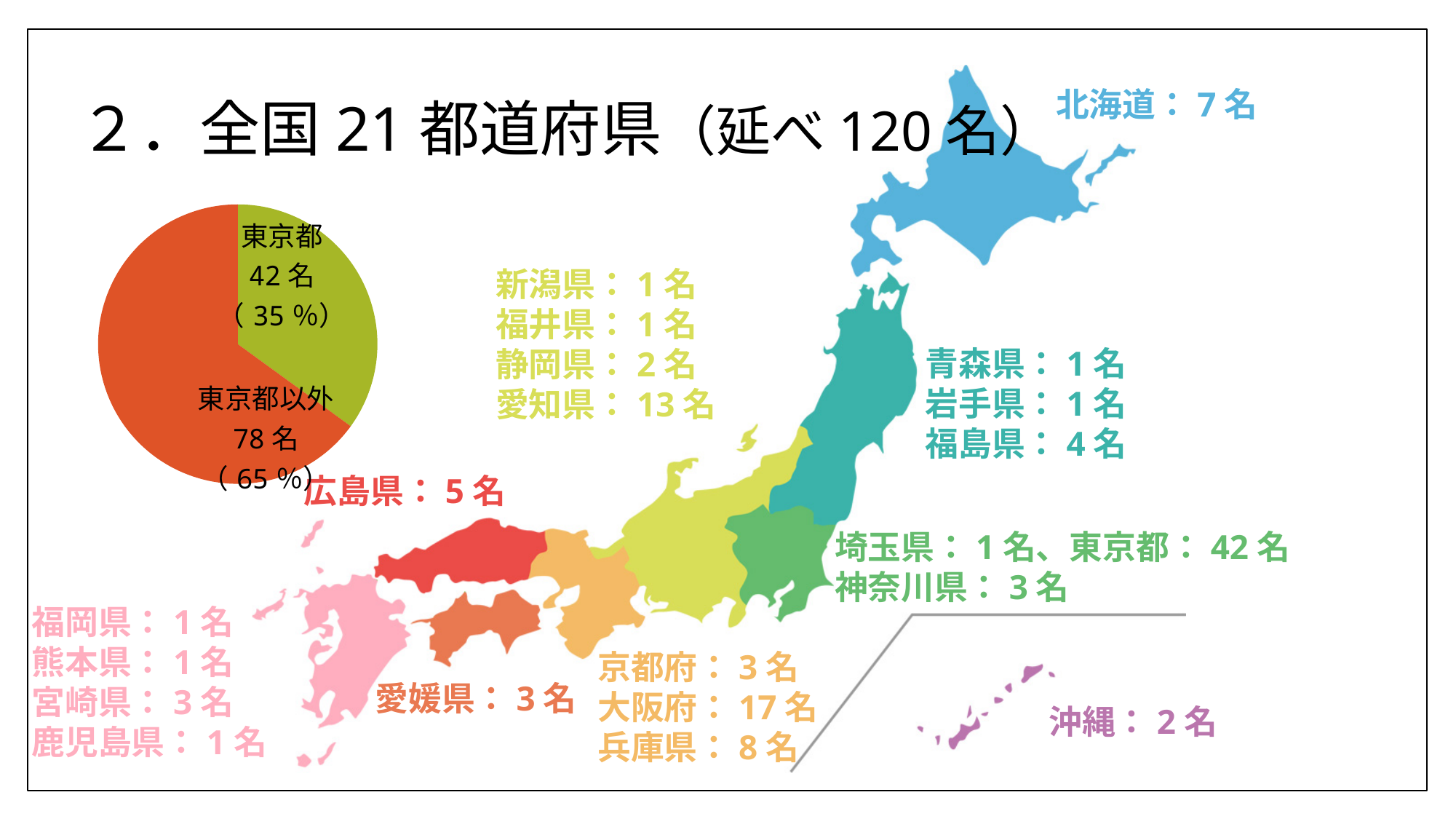
What colour is the 東京都 slice in the pie chart? yellow-green How many slices does the pie chart have? 2 In the pie chart, how many people are in the 東京都以外 slice? 78 名 In the pie chart, what share does the 東京都 slice represent? 35 % What kind of chart is shown on the left of the slide? pie chart Which slice of the pie chart is larger, 東京都 or 東京都以外? 東京都以外 What colour is the 東京都以外 slice in the pie chart? orange-red Which slice of the pie chart is the smallest? 東京都 In the pie chart, how many people are in the 東京都 slice? 42 名 What is the total number of people across both slices of the pie chart? 120 名 In the pie chart, what share does the 東京都以外 slice represent? 65 % What is the difference in people between the 東京都以外 slice and the 東京都 slice in the pie chart? 36 名